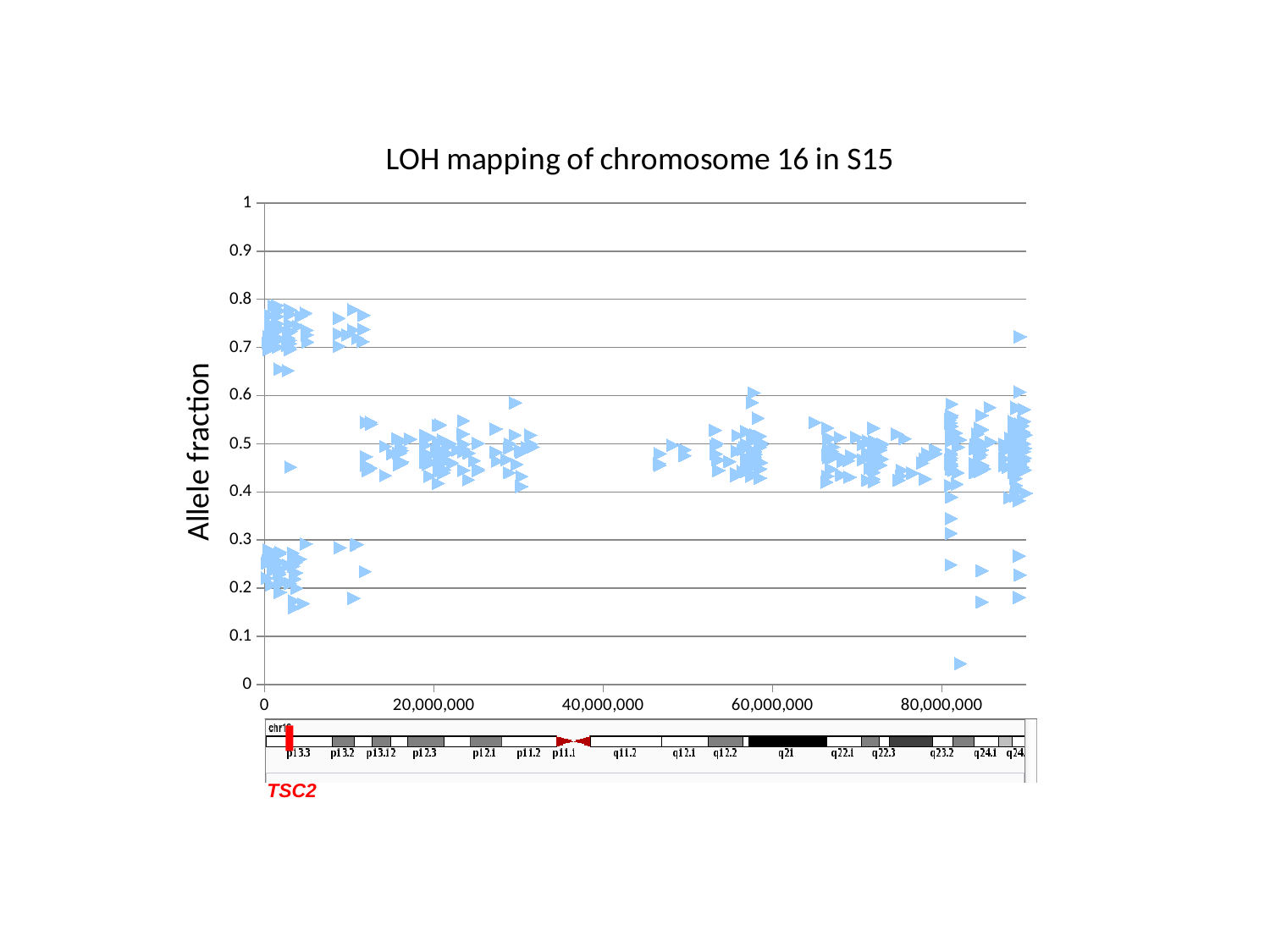
What is the largest tick value labelled on the horizontal axis? 80,000,000 Is the lowest plotted allele fraction greater or less than 0.1? less What kind of chart is shown on the slide? Scatter plot Is the highest plotted allele fraction greater or less than 0.9? less Which gene is labelled in red below the chart's horizontal axis? TSC2 What is the label on the vertical axis of the chart? Allele fraction Is the allele fraction of the point plotted near 80,000,000 at the bottom of the chart greater or less than 0.1? less What is the highest tick value shown on the vertical axis? 1 What is the title of the chart? LOH mapping of chromosome 16 in S15